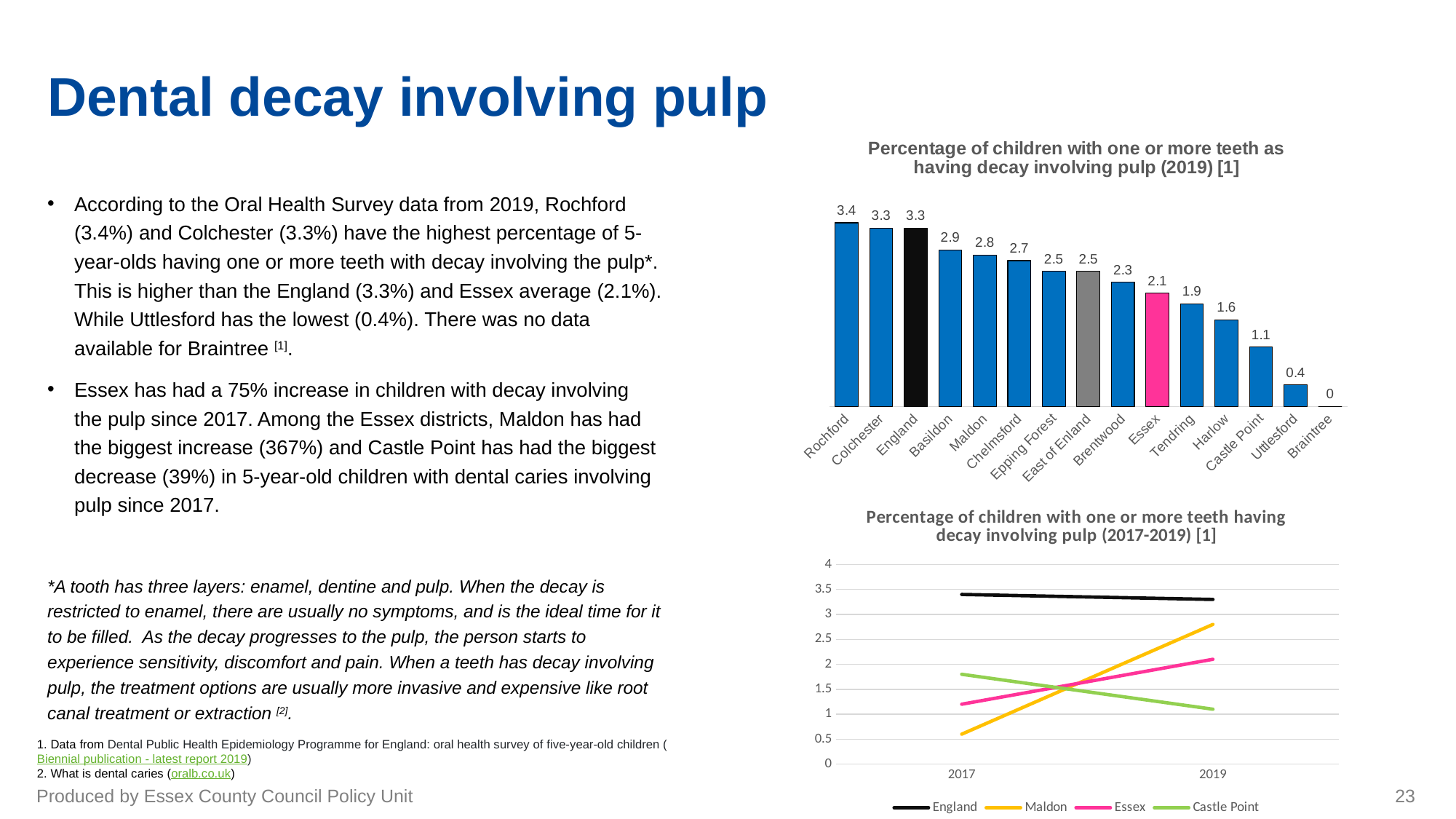
In the chart 'Percentage of children with one or more teeth having decay involving pulp (2017-2019)', does the Castle Point line rise or fall from 2017 to 2019? Fall In the chart 'Percentage of children with one or more teeth as having decay involving pulp (2019)', what is the value for Rochford? 3.4 What type of chart is the top chart on the slide, 'Percentage of children with one or more teeth as having decay involving pulp (2019)'? Bar chart How many series does the legend list in the chart 'Percentage of children with one or more teeth having decay involving pulp (2017-2019)'? 4 In the chart 'Percentage of children with one or more teeth as having decay involving pulp (2019)', what is the difference between the values for Rochford and Essex? 1.3 How many categories are shown on the x axis of the chart 'Percentage of children with one or more teeth as having decay involving pulp (2019)'? 15 In the chart 'Percentage of children with one or more teeth as having decay involving pulp (2019)', what is the value for Essex? 2.1 In the chart 'Percentage of children with one or more teeth as having decay involving pulp (2019)', which area has the highest value? Rochford In the chart 'Percentage of children with one or more teeth as having decay involving pulp (2019)', which is larger, the value for Basildon or the value for Tendring? Basildon In the chart 'Percentage of children with one or more teeth having decay involving pulp (2017-2019)', does the Maldon line rise or fall from 2017 to 2019? Rise In the chart 'Percentage of children with one or more teeth as having decay involving pulp (2019)', which area has the lowest non-zero value? Uttlesford In the chart 'Percentage of children with one or more teeth having decay involving pulp (2017-2019)', is the value for Maldon in 2019 greater or less than 2.5? greater